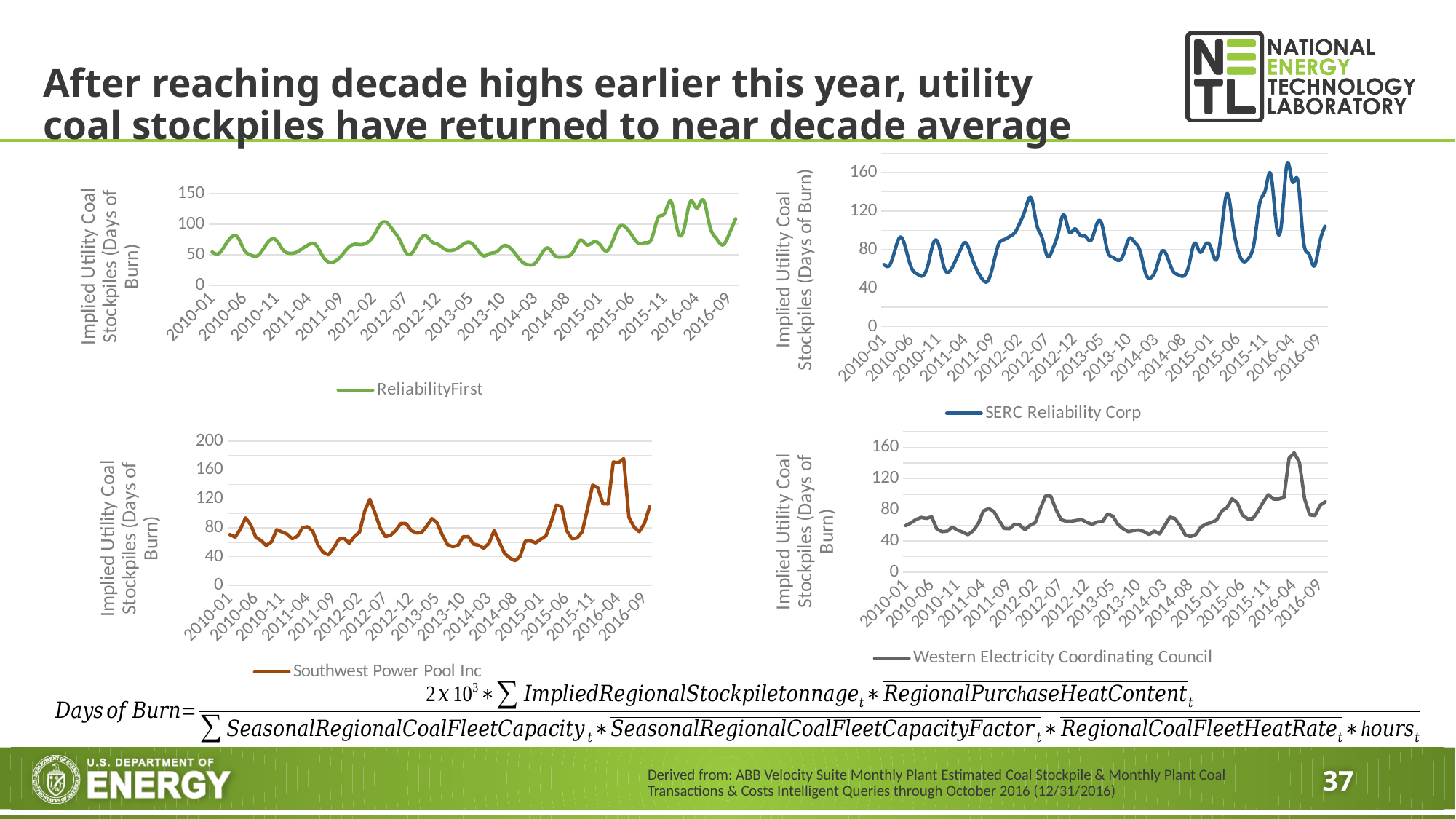
In the bottom-left Southwest Power Pool Inc chart, is the lowest value around 2014-08 greater or less than 40? less What series name appears in the legend of the bottom-left chart? Southwest Power Pool Inc What is the highest value shown on the y axis of the bottom-left Southwest Power Pool Inc chart? 200 In the bottom-left Southwest Power Pool Inc chart, is the peak value around 2016-04 greater or less than 120? greater What kind of chart is the top-left chart labelled ReliabilityFirst? Line chart In the top-right SERC Reliability Corp chart, is the peak value around 2016-04 greater or less than 120? greater In the top-left ReliabilityFirst chart, is the value at the end of the series (2016-09) higher or lower than at the start (2010-01)? higher What series name appears in the legend of the bottom-right chart? Western Electricity Coordinating Council How many series does the legend of the top-right chart list? 1